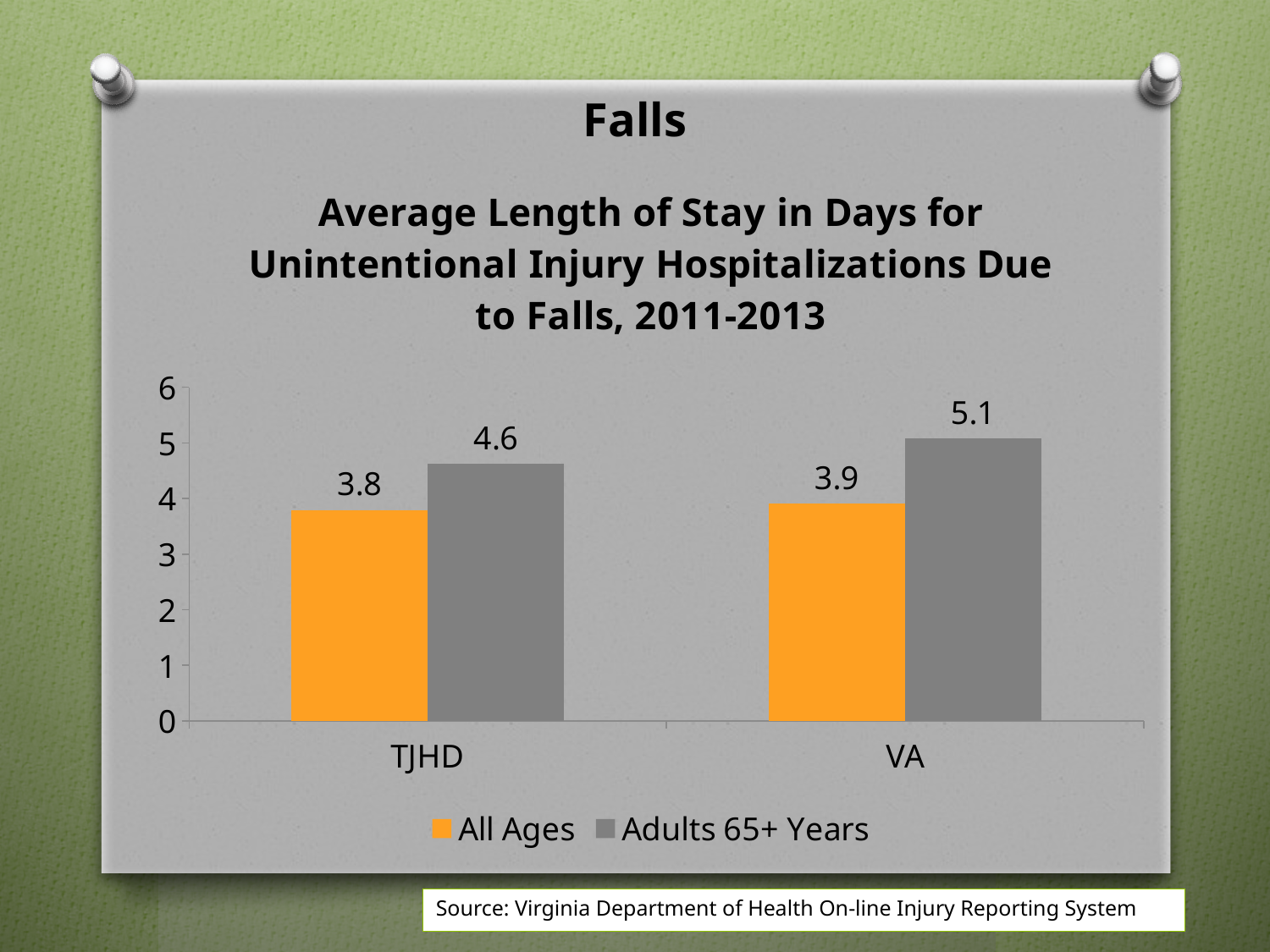
What is the difference between the Adults 65+ Years and All Ages values in TJHD? 0.8 How many series does the legend list? 2 What colour represents the All Ages series? Orange What kind of chart is shown on the slide? Bar chart Which bar shows the highest average length of stay? Adults 65+ Years in VA Which is larger, the Adults 65+ Years value for TJHD or for VA? VA What is the average length of stay for All Ages in VA? 3.9 What is the average length of stay for Adults 65+ Years in VA? 5.1 What is the average length of stay for All Ages in TJHD? 3.8 Which bar shows the lowest average length of stay? All Ages in TJHD What is the average length of stay for Adults 65+ Years in TJHD? 4.6 What is the difference between the Adults 65+ Years values for VA and TJHD? 0.5